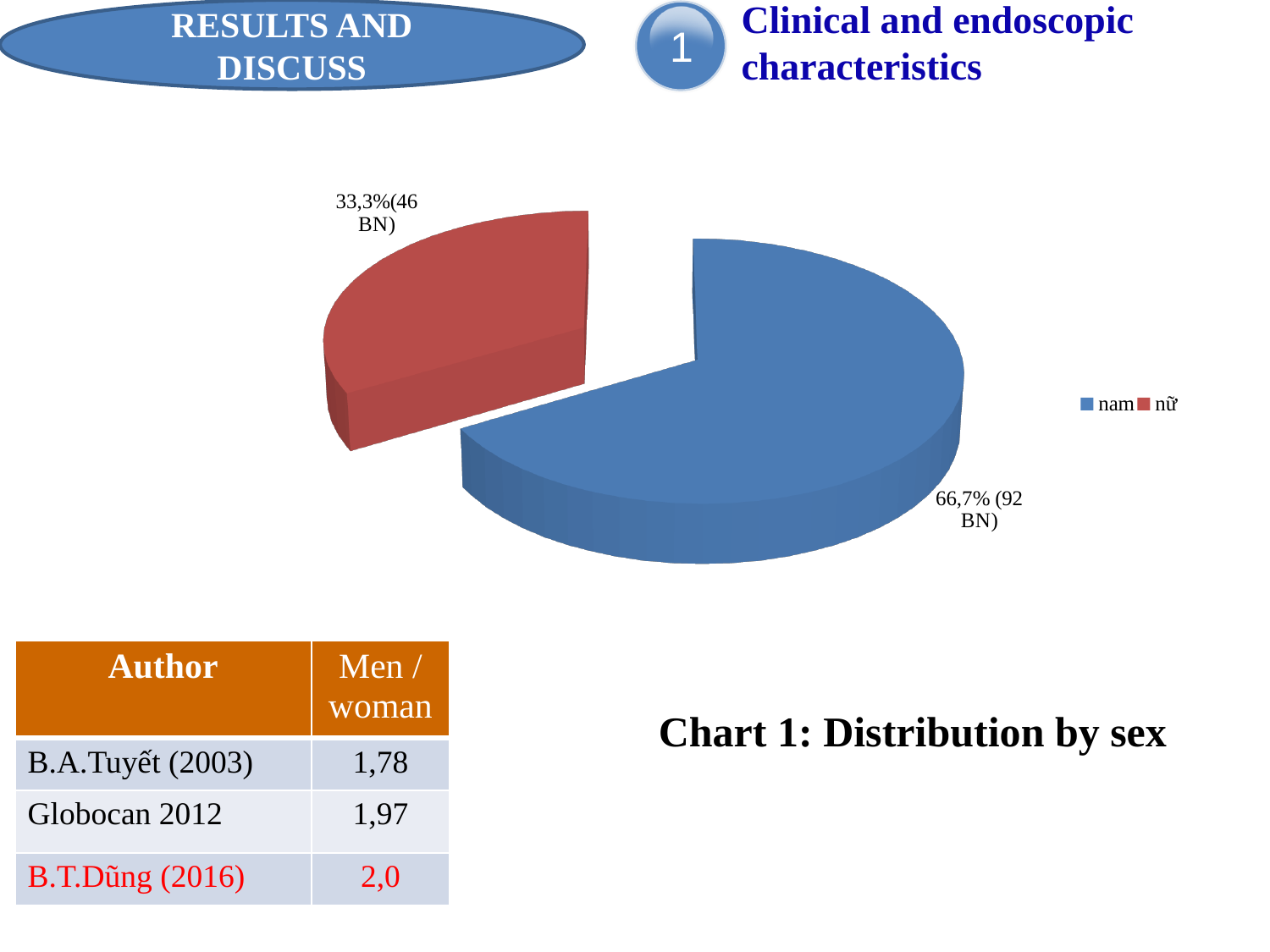
How many entries does the legend list? 2 What is the difference in percentage points between the 'nam' and 'nữ' slices? 33,4% What kind of chart is Chart 1: Distribution by sex? pie chart How many slices does the pie chart have? 2 How many patients (BN) are in the 'nữ' slice? 46 BN What share of the pie does the 'nam' slice represent? 66,7% Which is larger, the 'nam' slice or the 'nữ' slice? nam Which slice of the pie is the smallest? nữ How many patients (BN) are in the 'nam' slice? 92 BN Which slice of the pie is the largest? nam What share of the pie does the 'nữ' slice represent? 33,3% What colour is the 'nữ' slice in the pie chart? red